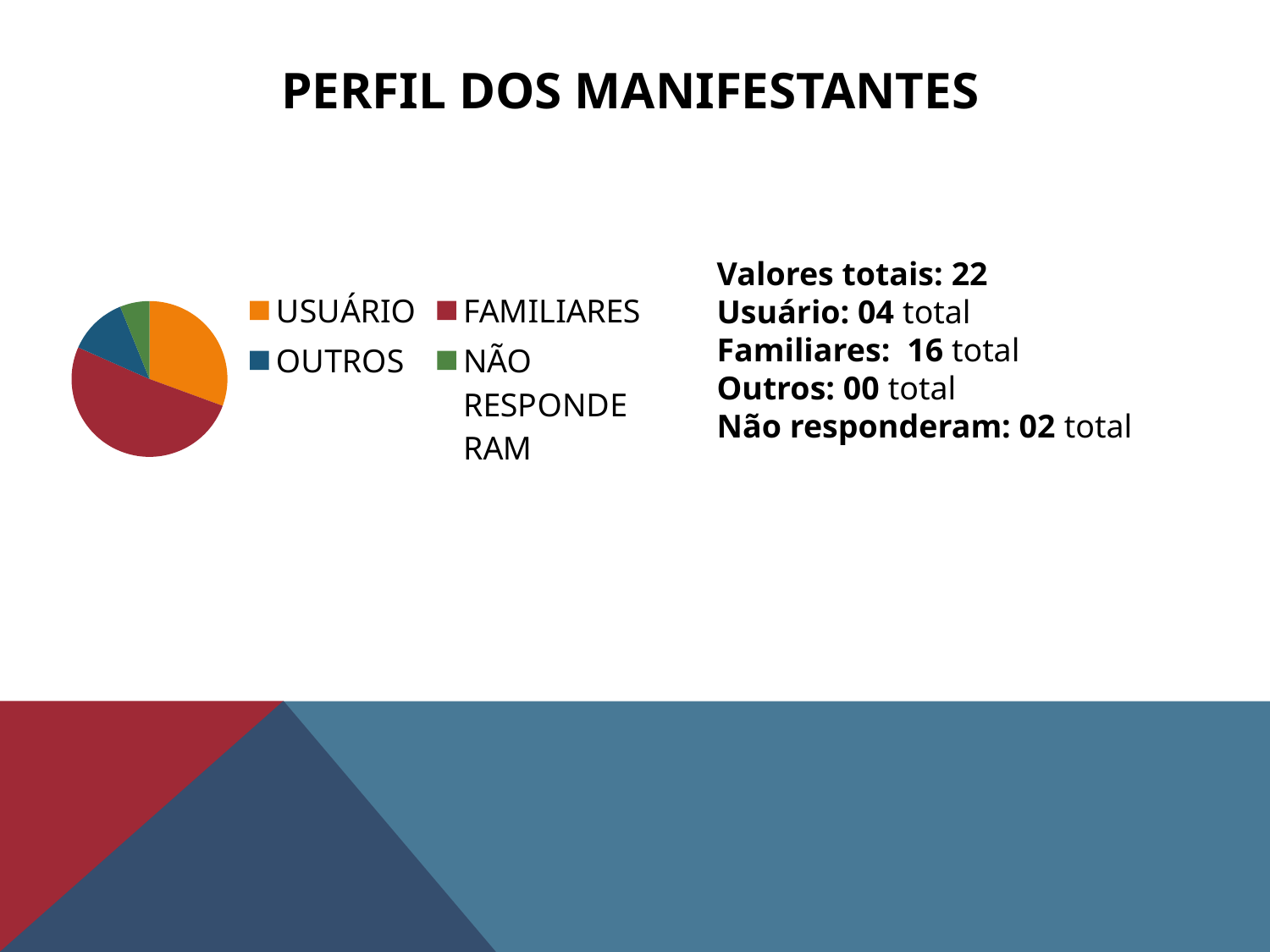
Which slice is larger in the pie chart, OUTROS or NÃO RESPONDERAM? OUTROS What kind of chart is shown on the slide? pie chart What colour is the FAMILIARES slice in the pie chart? red Which category has the smallest slice in the pie chart? NÃO RESPONDERAM Which category has the largest slice in the pie chart? FAMILIARES Which slice is larger in the pie chart, FAMILIARES or USUÁRIO? FAMILIARES What is the title of the slide containing the pie chart? PERFIL DOS MANIFESTANTES Which slice is larger in the pie chart, USUÁRIO or OUTROS? USUÁRIO How many categories does the pie chart's legend list? 4